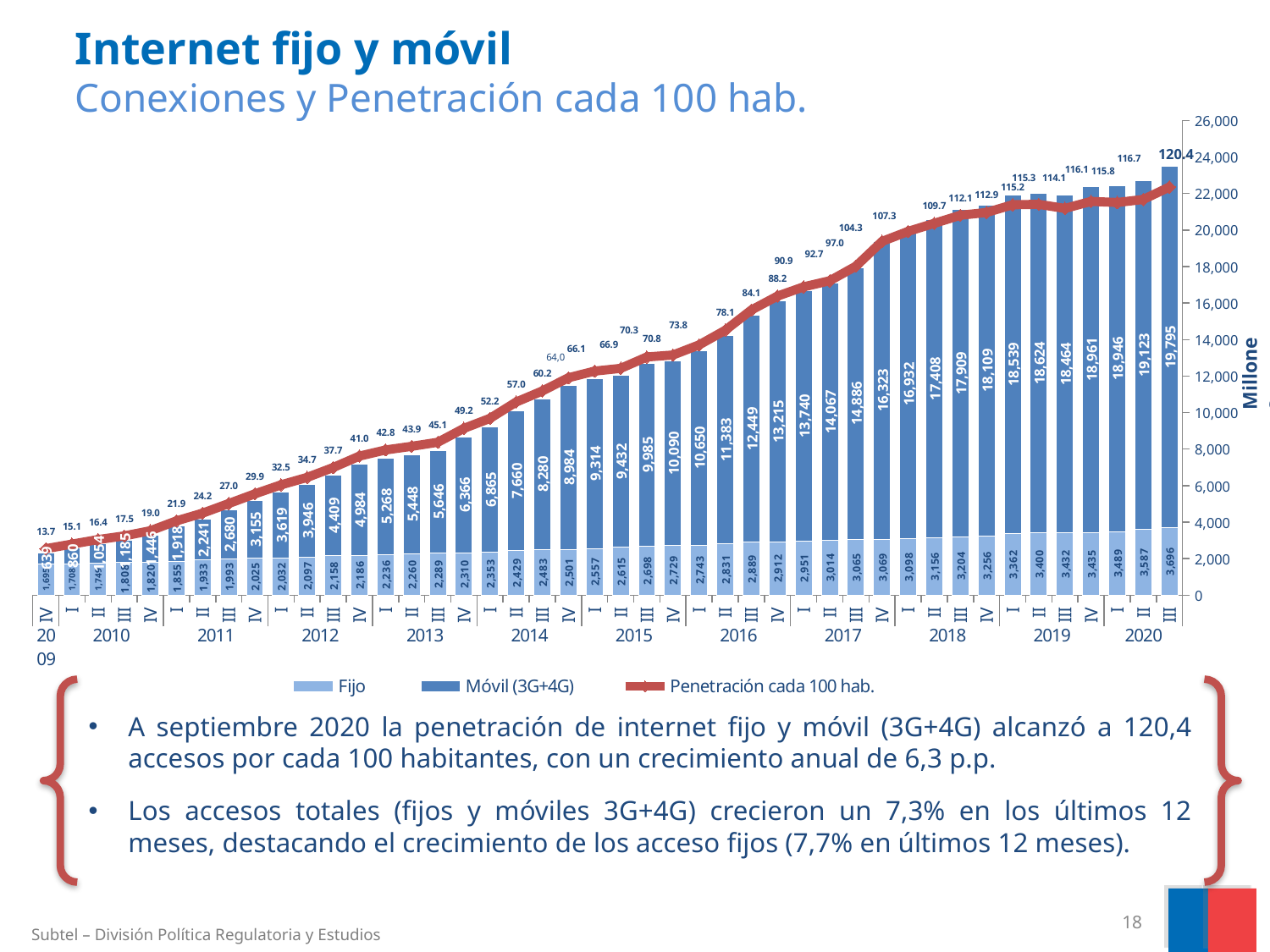
How many series does the legend list? 3 Which is larger, the Móvil (3G+4G) value for II 2019 or for III 2019? II 2019 Which quarter has the highest Penetración cada 100 hab. value? III 2020 What is the Fijo value for III 2020? 3,696 What is the Móvil (3G+4G) value for III 2020? 19,795 What is the Penetración cada 100 hab. value for III 2020? 120.4 What kind of chart is shown on the slide? Stacked bar chart with a line What is the difference between the Móvil (3G+4G) values for III 2020 and II 2020? 672 What is the Móvil (3G+4G) value for IV 2017? 16,323 What is the Penetración cada 100 hab. value for IV 2009? 13.7 Does the Penetración cada 100 hab. line generally rise or fall from IV 2009 to III 2020? rise What is the total of the stacked bar (Fijo plus Móvil) for III 2020? 23,491